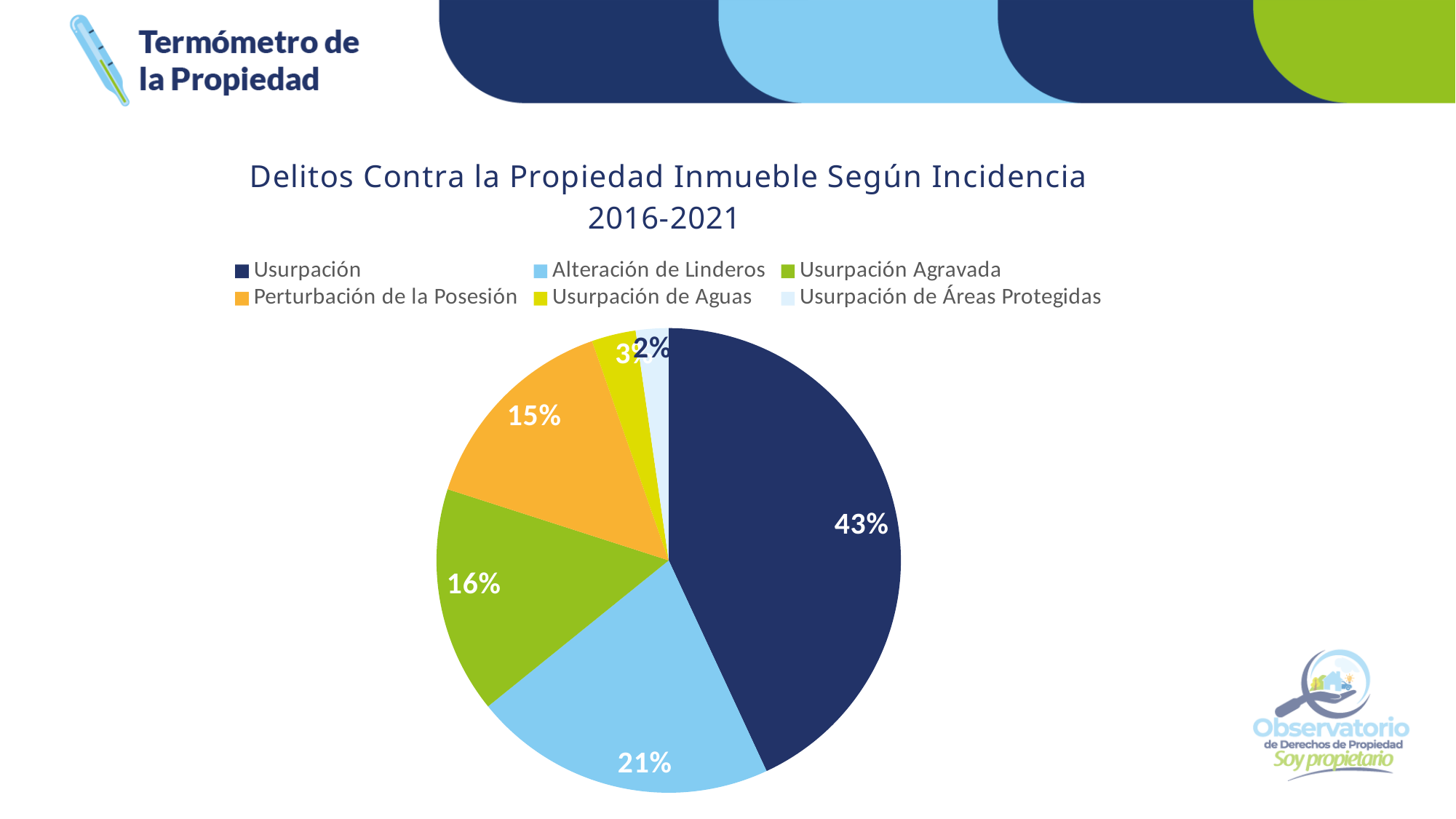
What is the value shown for Usurpación Agravada? 16% What is the value shown for Usurpación de Áreas Protegidas? 2% What is the difference in percentage points between Usurpación and Alteración de Linderos? 22 percentage points What is the value shown for Perturbación de la Posesión? 15% What is the value shown for Alteración de Linderos? 21% What is the title of the chart? Delitos Contra la Propiedad Inmueble Según Incidencia 2016-2021 What colour is the slice for Usurpación? dark blue How many categories are shown in the pie chart? 6 Which is larger, Usurpación Agravada or Perturbación de la Posesión? Usurpación Agravada Which category has the largest slice of the pie? Usurpación What kind of chart is shown on the slide? pie chart What percentage of the pie does Usurpación represent? 43%